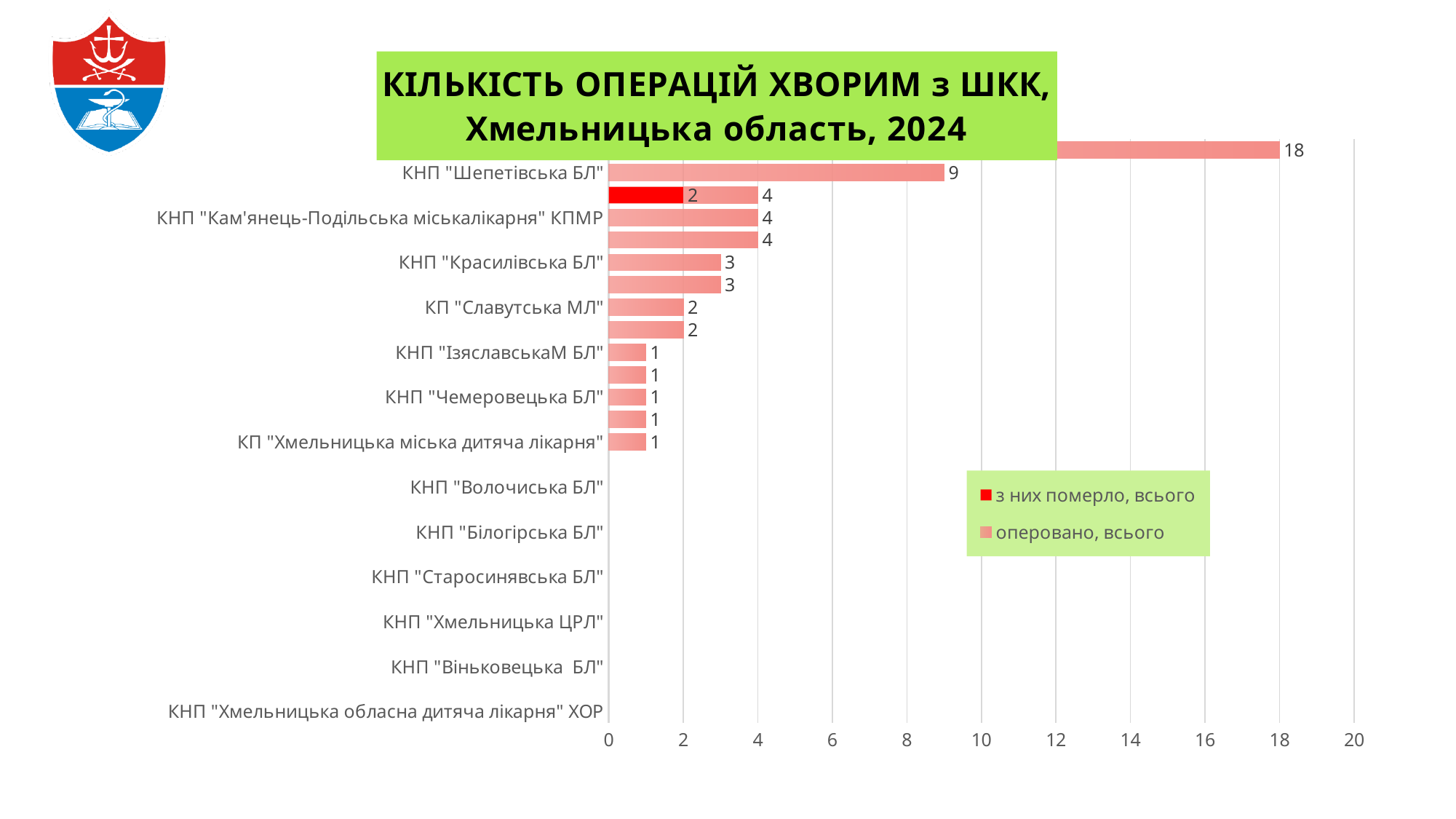
What is the value of "оперовано, всього" for КНП "Кам'янець-Подільська міськалікарня" КПМР? 4 Which has a larger "оперовано, всього" value: КНП "Кам'янець-Подільська міськалікарня" КПМР or КП "Славутська МЛ"? КНП "Кам'янець-Подільська міськалікарня" КПМР Which legend entry is shown in red? з них померло, всього Is the "оперовано, всього" value for КНП "Шепетівська БЛ" greater or less than 10? less What is the value of "оперовано, всього" for КНП "Шепетівська БЛ"? 9 What is the value of "оперовано, всього" for КП "Славутська МЛ"? 2 What type of chart is shown on the slide? bar chart What is the value of "оперовано, всього" for КНП "Красилівська БЛ"? 3 What is the largest data label value shown on the chart? 18 What is the difference between the "оперовано, всього" values for КНП "Шепетівська БЛ" and КНП "Красилівська БЛ"? 6 What is the value of "оперовано, всього" for КП "Хмельницька міська дитяча лікарня"? 1 How many series does the legend list? 2